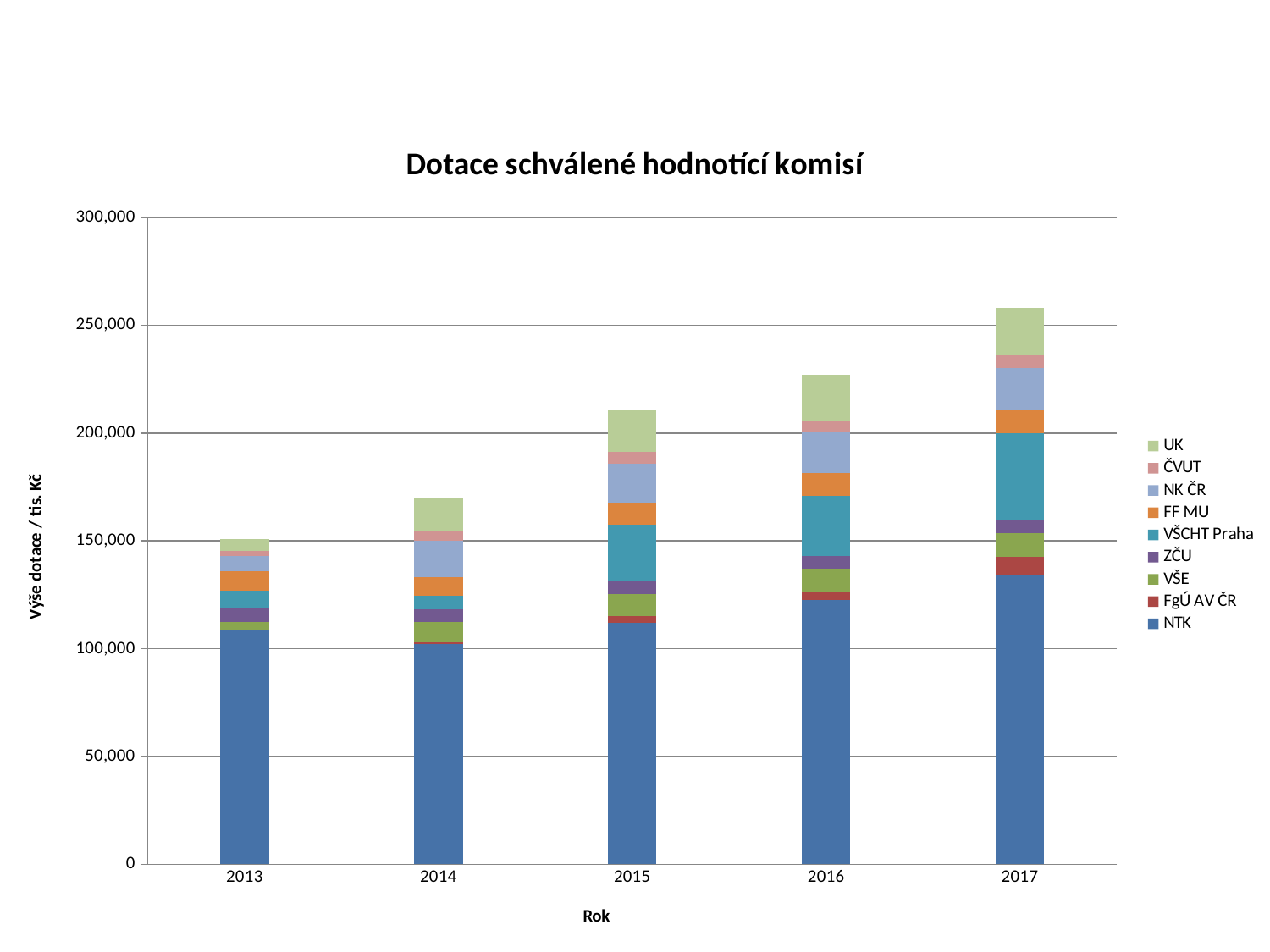
Is the total for 2017 greater or less than 250,000? greater Is the total for 2014 greater or less than 200,000? less Which year has the lowest total stacked bar? 2013 What is the label of the y axis? Výše dotace / tis. Kč Is the total for 2015 greater or less than 200,000? greater How many years are shown on the x axis? 5 Do the total bar heights rise or fall from 2013 to 2017? rise Which year has the highest total stacked bar? 2017 What is the title of the chart? Dotace schválené hodnotící komisí What kind of chart is shown on the slide? stacked bar chart Is the total for 2016 larger than the total for 2015? yes How many series does the legend list? 9